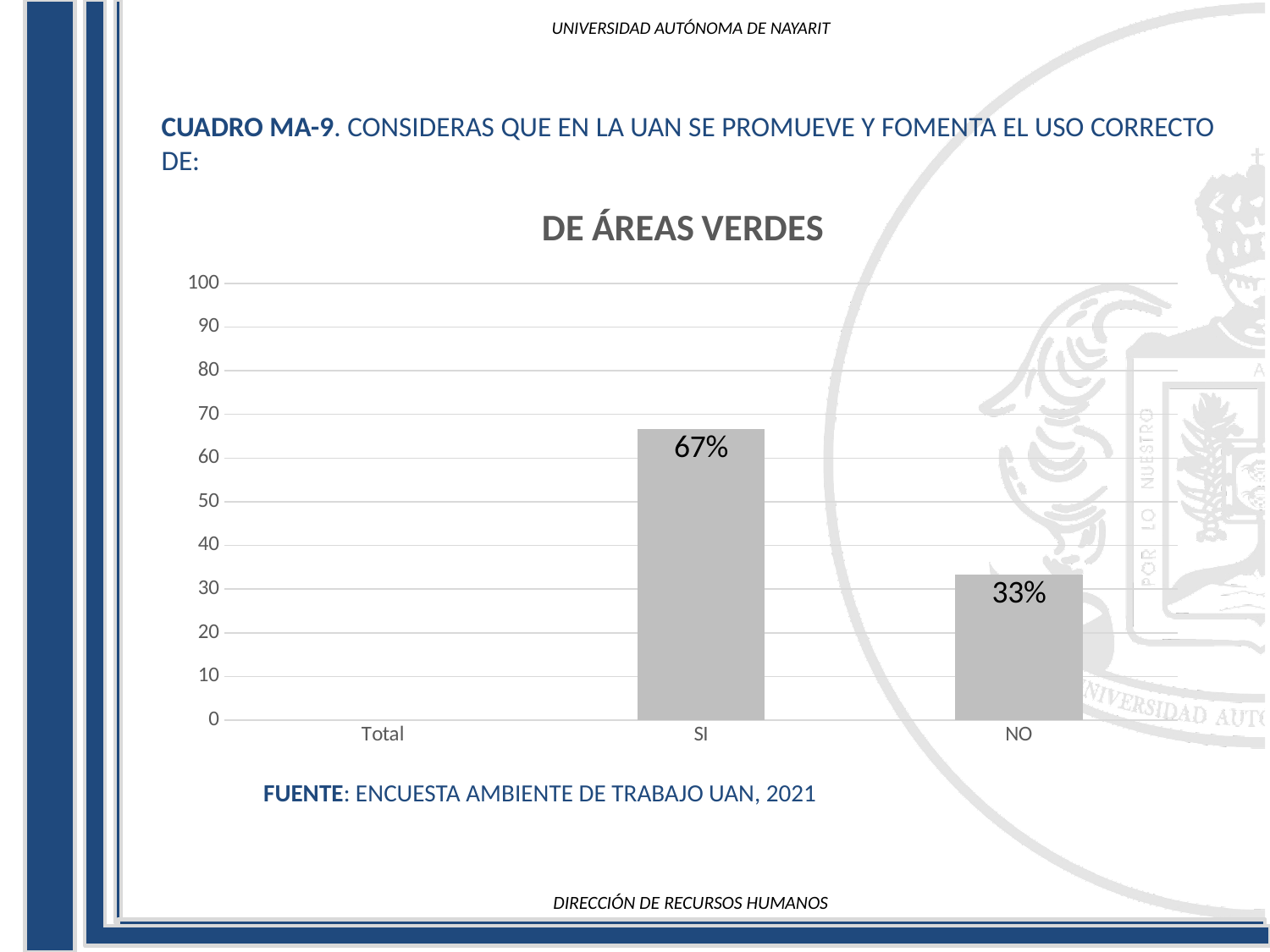
Is the value for NO greater or less than 40? less What is the difference between the values for SI and NO? 34% Which category has the lowest value among those with a visible bar? NO What is the maximum value shown on the y axis? 100 Which category has the highest value? SI What is the value for SI? 67% What is the value for NO? 33% How many categories are shown on the x axis? 3 What is the title of the chart? DE ÁREAS VERDES Is the value for SI greater or less than 60? greater What kind of chart is shown? bar chart Which is larger, the value for SI or the value for NO? SI